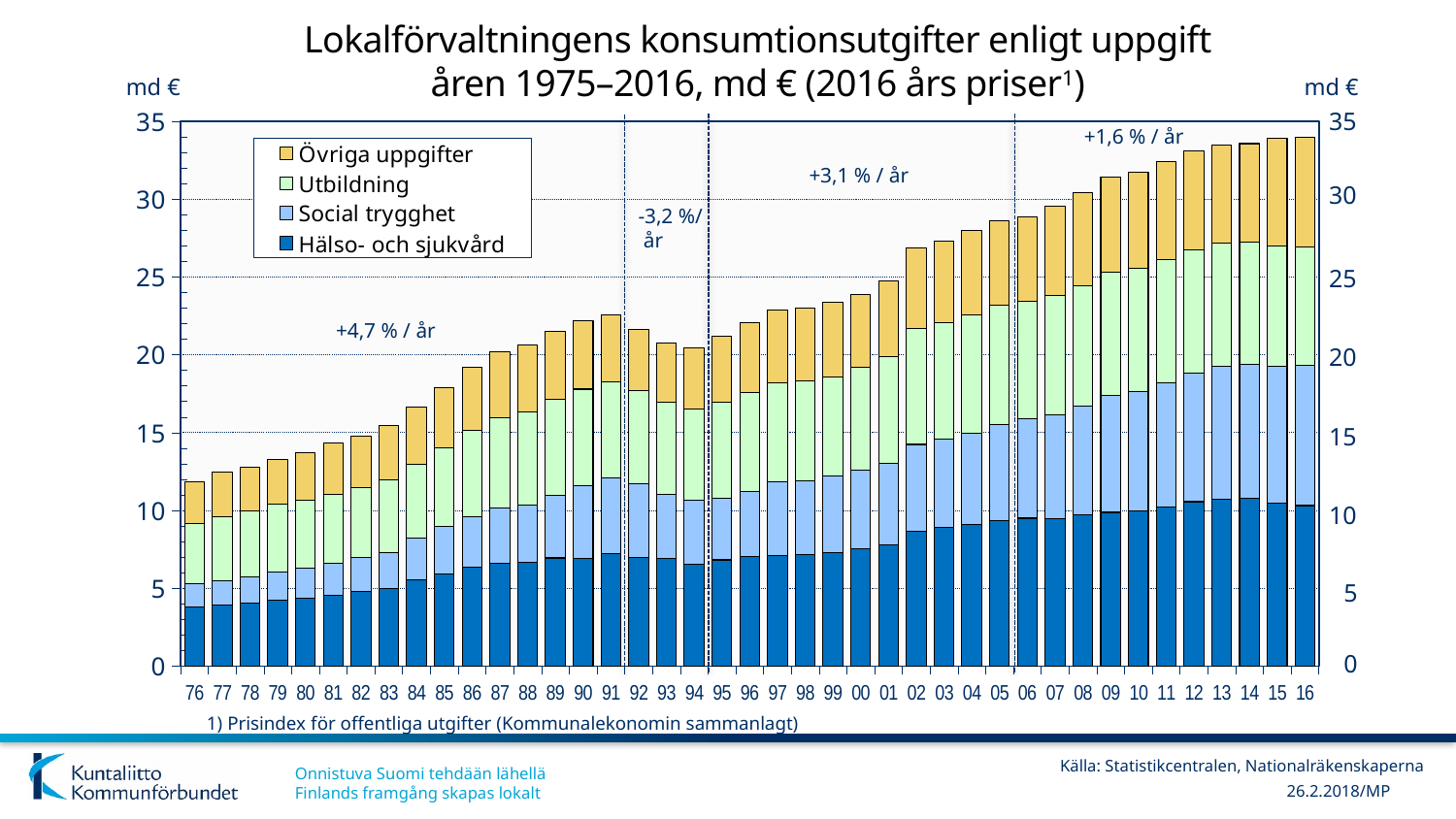
What unit is shown on the y axis? md € How many series does the legend list? 4 How many years (bars) are plotted along the x axis? 41 Is the total bar for 16 greater or less than 30? greater What annual growth rate is annotated for the period between the 1995 and 2005 dividing lines? +3,1 % / år Which total bar is larger, 76 or 16? 16 Is the total bar for 76 greater or less than 15? less What kind of chart is shown on the slide? stacked bar chart Is the Hälso- och sjukvård value for 76 greater or less than 5? less Which year has the lowest total bar? 76 Do the total bars generally rise or fall from 76 to 16? rise